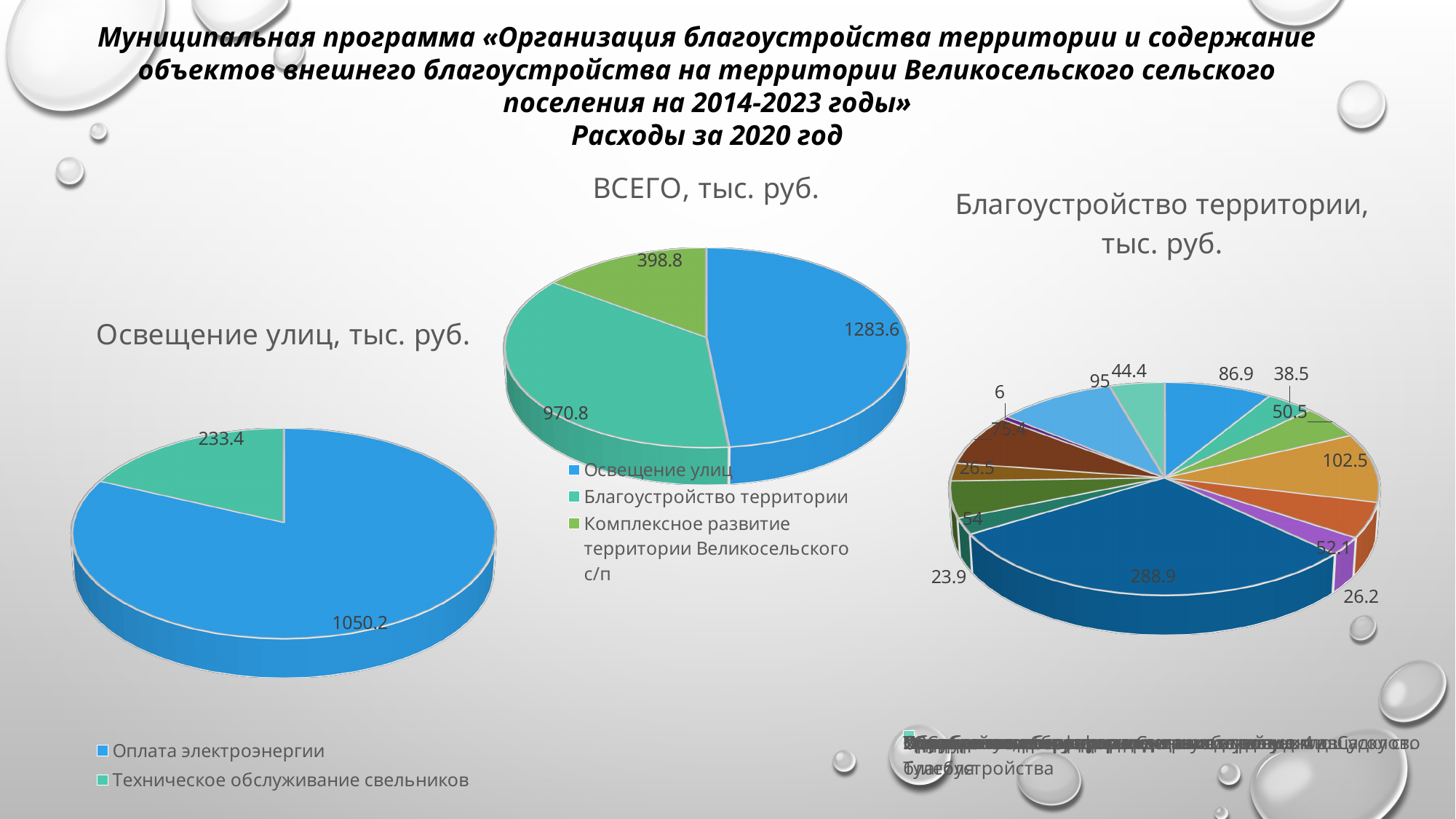
On the 'ВСЕГО, тыс. руб.' chart, which category has the smallest value? Комплексное развитие территории Великосельского с/п On the 'ВСЕГО, тыс. руб.' chart, which is larger: Освещение улиц or Благоустройство территории? Освещение улиц On the 'ВСЕГО, тыс. руб.' chart, how many categories does the legend list? 3 On the 'Освещение улиц, тыс. руб.' chart, which category has the larger value? Оплата электроэнергии On the 'Освещение улиц, тыс. руб.' chart, what is the value for Оплата электроэнергии? 1050.2 On the 'ВСЕГО, тыс. руб.' chart, what is the value for Комплексное развитие территории Великосельского с/п? 398.8 On the 'Благоустройство территории, тыс. руб.' chart, what is the largest value shown? 288.9 What type of chart is the 'ВСЕГО, тыс. руб.' chart? Pie chart On the 'ВСЕГО, тыс. руб.' chart, what is the value for Благоустройство территории? 970.8 On the 'Освещение улиц, тыс. руб.' chart, what is the value for Техническое обслуживание свельников? 233.4 On the 'ВСЕГО, тыс. руб.' chart, what is the total of the three values shown? 2653.2 On the 'Освещение улиц, тыс. руб.' chart, what is the difference between Оплата электроэнергии and Техническое обслуживание свельников? 816.8